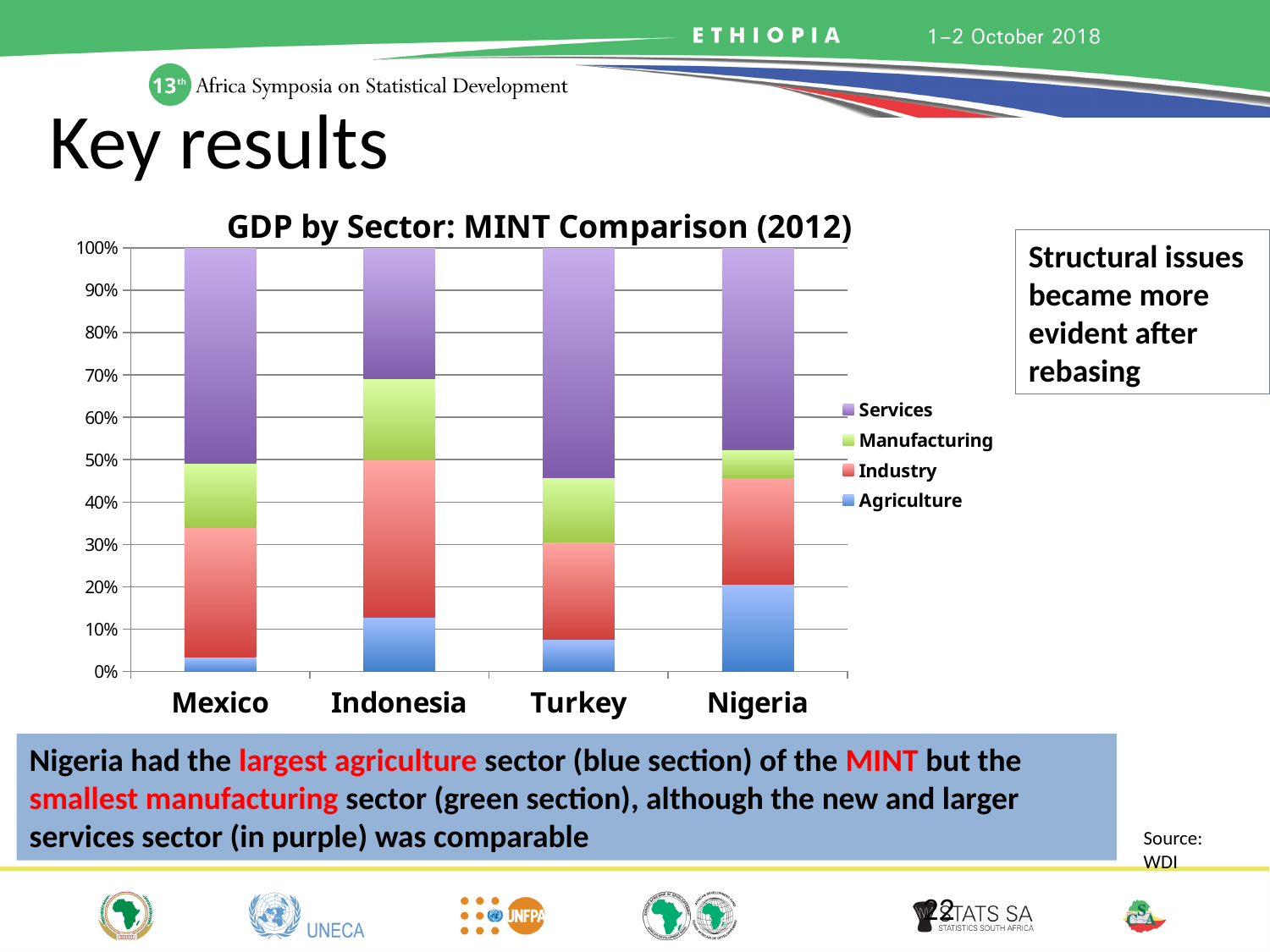
Which colour represents Agriculture in the chart? Blue How many countries are shown on the x axis of the chart? 4 How many series does the chart's legend list? 4 Which country has the smallest Agriculture share in the chart? Mexico Is the Agriculture share for Nigeria greater or less than 10%? greater Which country has the smallest Services share in the chart? Indonesia Is the Services share for Indonesia greater or less than 40%? less Which is larger, the Manufacturing share for Indonesia or for Nigeria? Indonesia Which country has the smallest Manufacturing share in the chart? Nigeria What is the title of the chart? GDP by Sector: MINT Comparison (2012) Which country has the largest Agriculture share in the chart? Nigeria What kind of chart is shown on the slide? Stacked bar chart